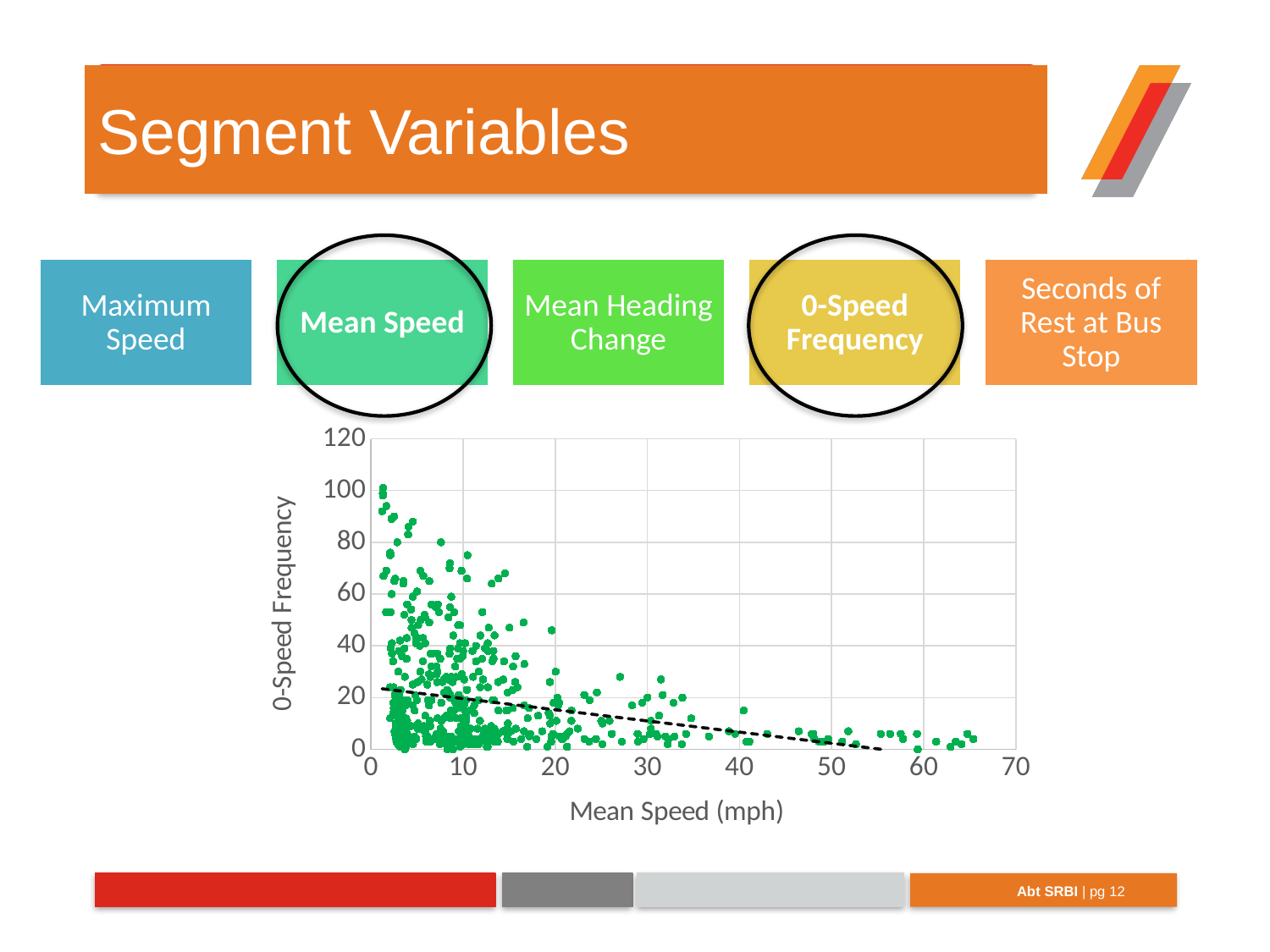
What is the highest value shown on the y axis of the chart? 120 What kind of chart is shown on the slide? scatter chart Is the 0-Speed Frequency of the highest plotted point greater or less than 80? greater Are the 0-Speed Frequency values of the points with Mean Speed above 60 mph greater or less than 20? less Do the points with the highest 0-Speed Frequency occur at low or high Mean Speed? low What is the label of the y axis of the chart? 0-Speed Frequency Does the dashed trend line rise or fall as Mean Speed increases? fall What is the label of the x axis of the chart? Mean Speed (mph) Is the dashed trend line's value at a Mean Speed of 50 mph greater or less than 20? less What is the highest value shown on the x axis of the chart? 70